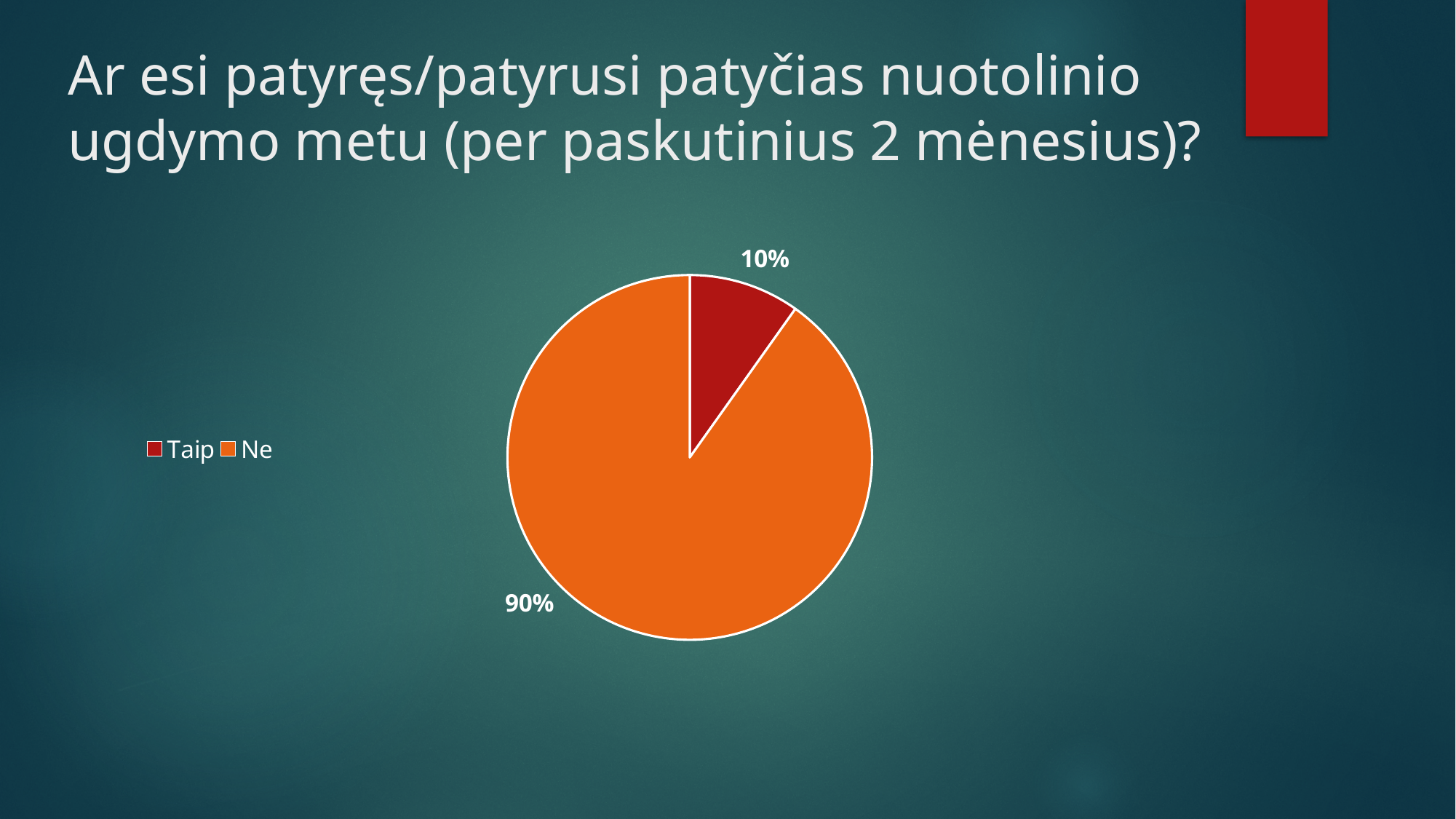
How many categories does the pie chart show? 2 How many entries does the legend list? 2 What colour is the "Ne" slice? orange What share of the pie does "Ne" represent? 90% Which category has the largest slice of the pie? Ne Which slice is larger, "Taip" or "Ne"? Ne Which category has the smallest slice of the pie? Taip What share of the pie does "Taip" represent? 10% What is the difference in percentage points between the "Ne" and "Taip" slices? 80 What kind of chart is shown on the slide? pie chart What colour is the "Taip" slice? dark red